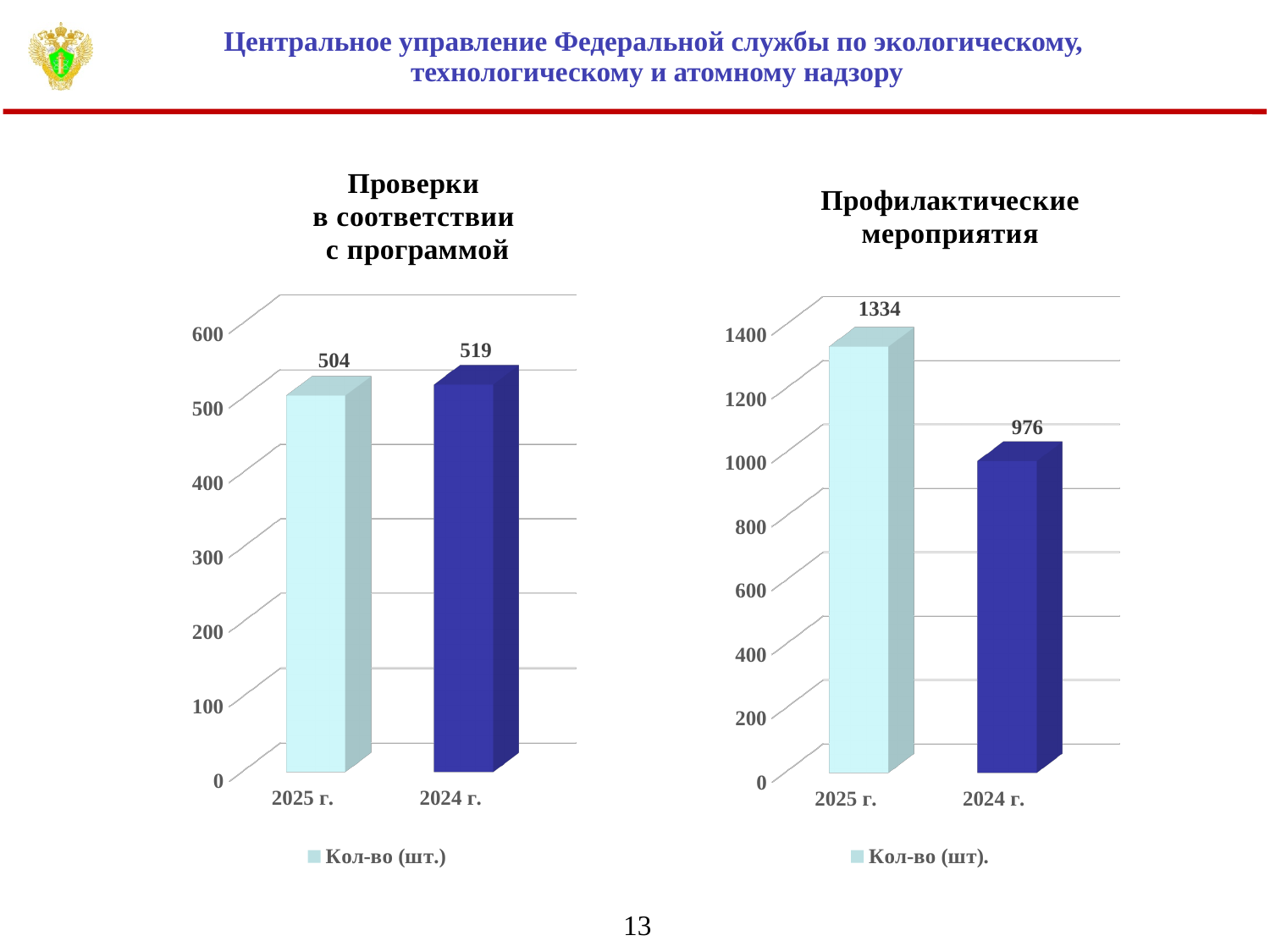
How many categories are shown in the chart titled 'Проверки в соответствии с программой'? 2 In the chart titled 'Профилактические мероприятия', is the value for 2024 г. greater or less than 1000? less In the chart titled 'Проверки в соответствии с программой', what is the value for 2025 г.? 504 In the chart titled 'Профилактические мероприятия', what is the value for 2024 г.? 976 In the chart titled 'Профилактические мероприятия', what is the value for 2025 г.? 1334 In the chart titled 'Профилактические мероприятия', what is the difference between the values for 2025 г. and 2024 г.? 358 What kind of chart is the chart titled 'Профилактические мероприятия'? bar chart In the chart titled 'Проверки в соответствии с программой', what is the difference between the values for 2024 г. and 2025 г.? 15 In the chart titled 'Проверки в соответствии с программой', what is the value for 2024 г.? 519 In the chart titled 'Проверки в соответствии с программой', which year has the lowest value? 2025 г. In the chart titled 'Профилактические мероприятия', which year has the highest value? 2025 г. What is the legend entry shown under the chart titled 'Проверки в соответствии с программой'? Кол-во (шт.)